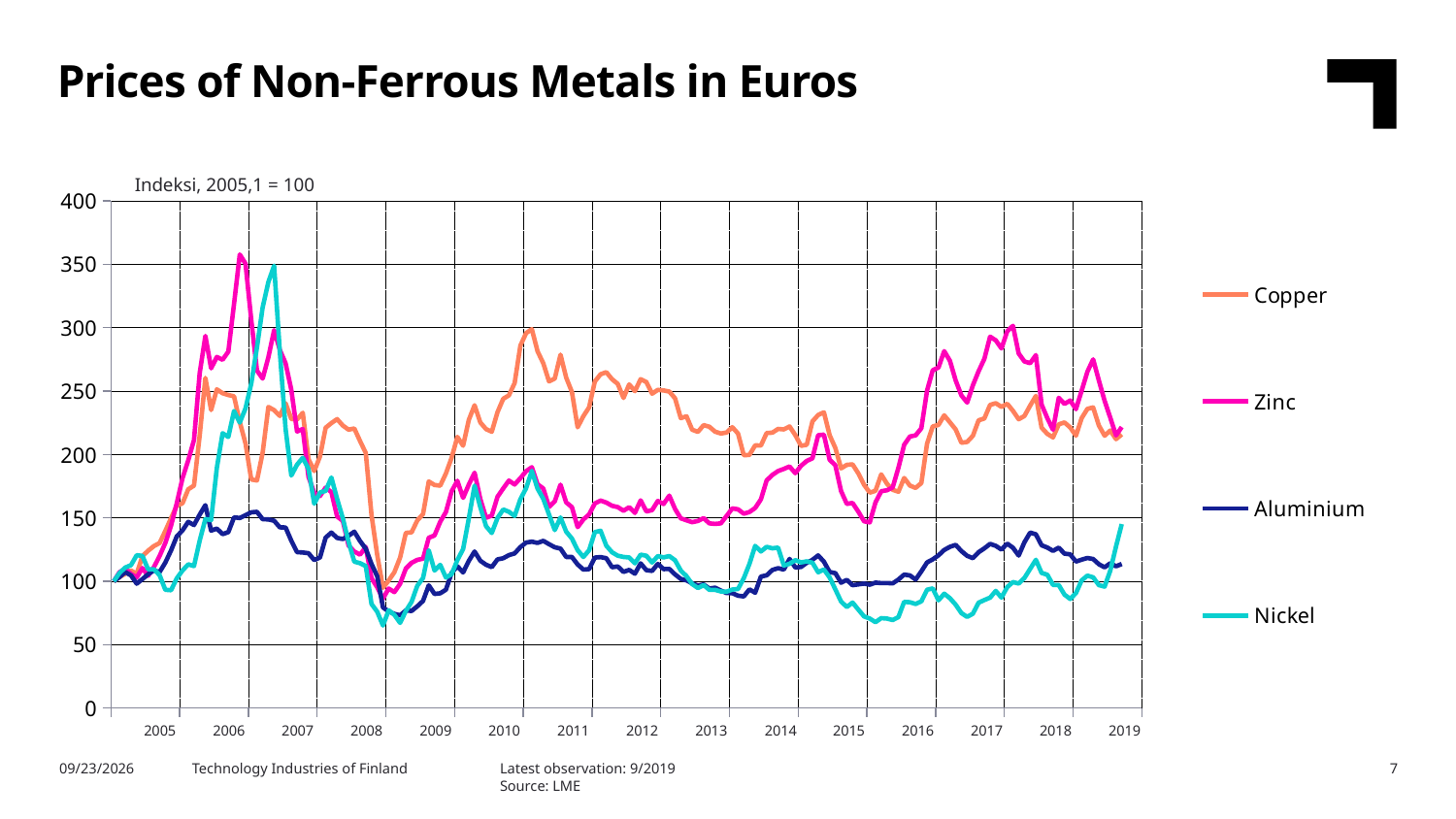
In 2016, which is higher, Zinc or Nickel? Zinc Is the peak value for Zinc in 2006 greater or less than 300? greater Which series has the lowest value at the end of the series in 2019? Aluminium What kind of chart is shown on the slide? line chart Is the value for Aluminium at the end of the series in 2019 greater or less than 150? less What base period is the index set to 100, according to the axis label? 2005,1 What is the title of the chart? Prices of Non-Ferrous Metals in Euros Which series has the highest value in 2012? Copper Is the peak value for Nickel in 2006 greater or less than 300? less How many series does the legend list? 4